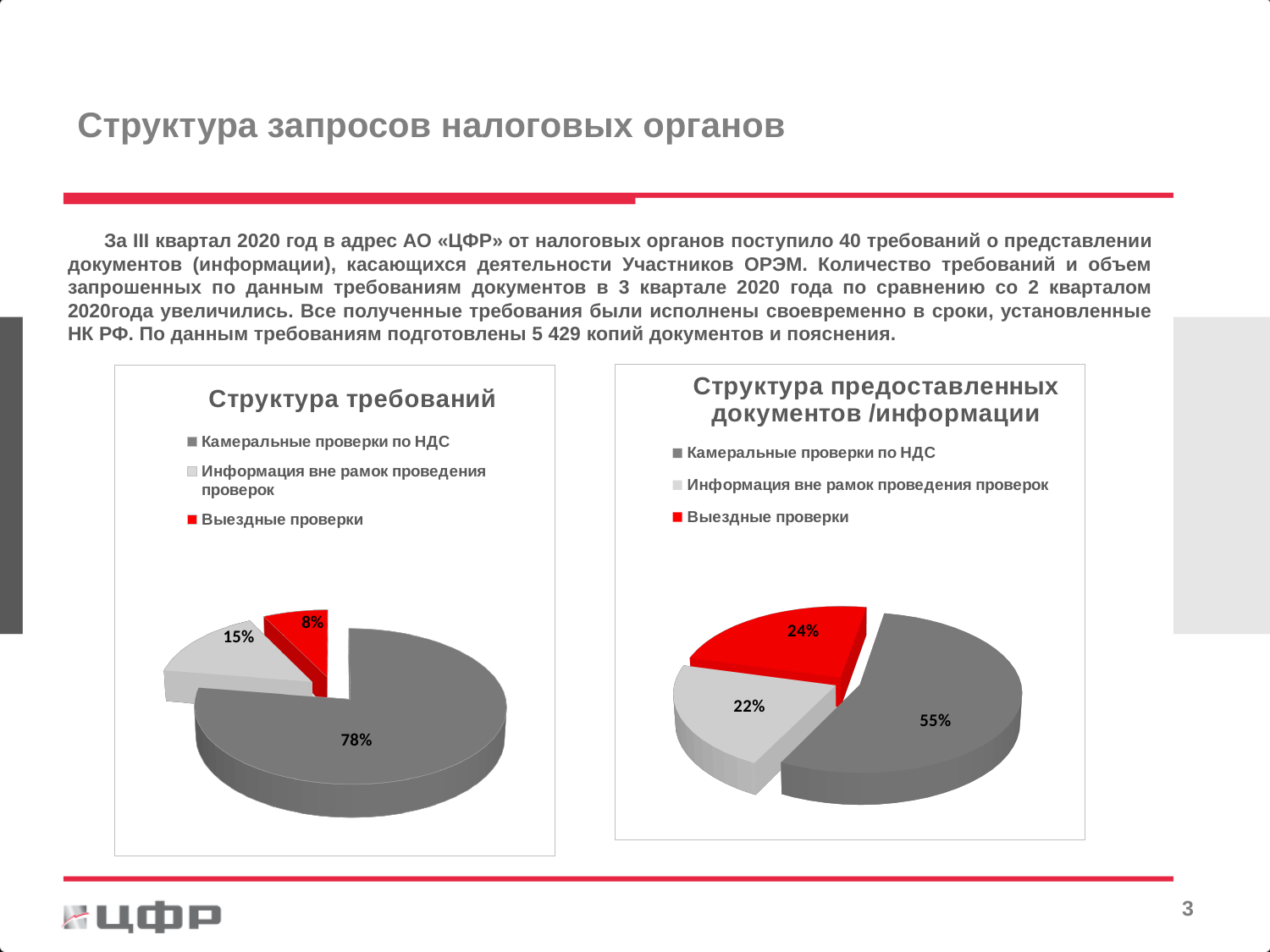
In the chart titled "Структура требований", which category has the largest share? Камеральные проверки по НДС In the chart titled "Структура предоставленных документов /информации", what share does "Выездные проверки" have? 24% In the chart titled "Структура требований", which category has the smallest share? Выездные проверки In the chart titled "Структура требований", what share does "Камеральные проверки по НДС" have? 78% In the chart titled "Структура требований", what share does "Выездные проверки" have? 8% How many categories does the legend of the chart titled "Структура требований" list? 3 In the chart titled "Структура предоставленных документов /информации", what share does "Информация вне рамок проведения проверок" have? 22% In the chart titled "Структура требований", what share does "Информация вне рамок проведения проверок" have? 15% In the chart titled "Структура предоставленных документов /информации", which category has the smallest share? Информация вне рамок проведения проверок In the chart titled "Структура требований", what is the difference in percentage points between "Камеральные проверки по НДС" and "Информация вне рамок проведения проверок"? 63 In the chart titled "Структура предоставленных документов /информации", what share does "Камеральные проверки по НДС" have? 55% What type of chart is the chart titled "Структура предоставленных документов /информации"? Pie chart